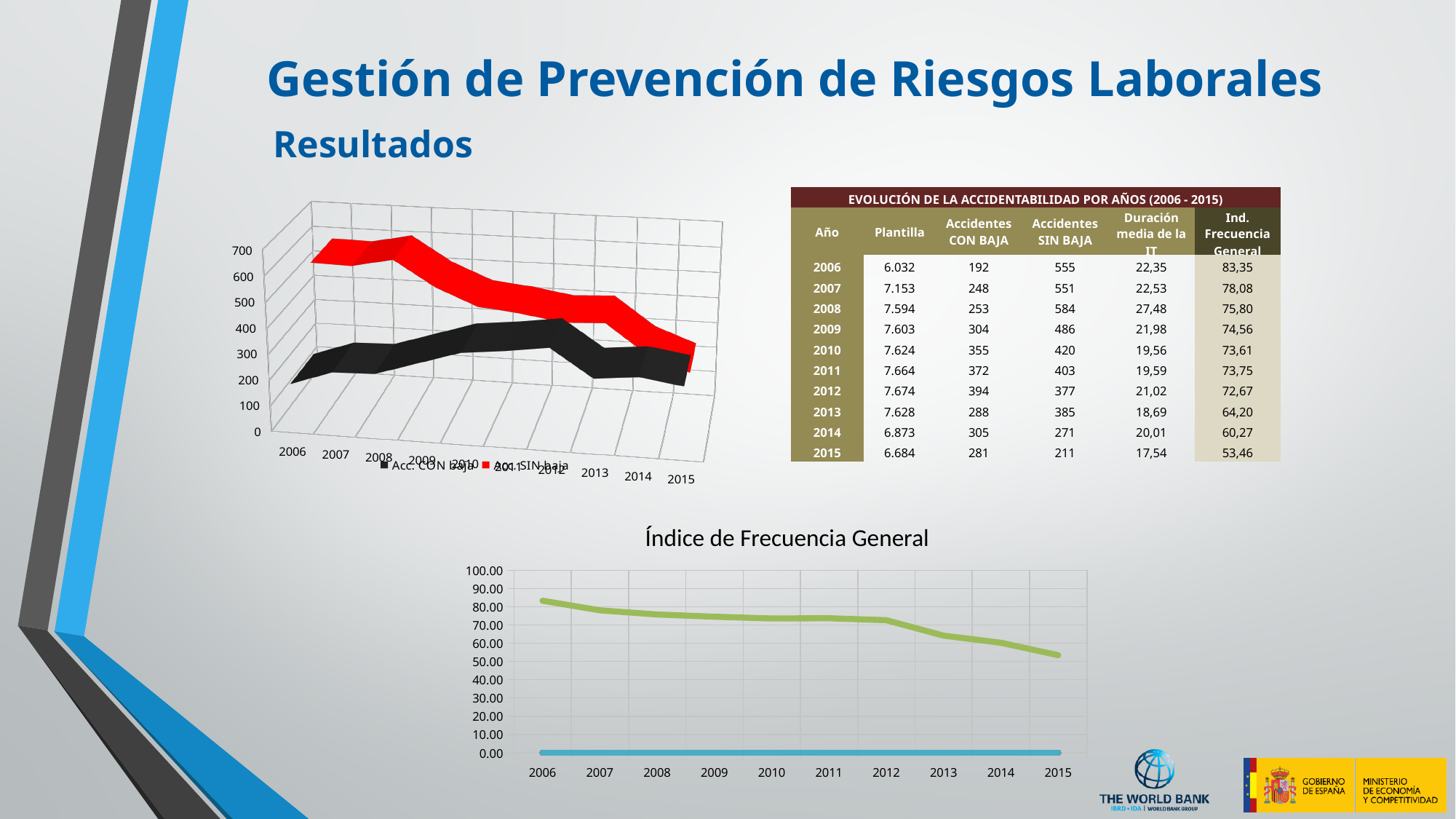
In the 'Índice de Frecuencia General' chart, which year has the highest value? 2006 In the top-left 3D chart, does the 'Acc. SIN baja' series rise or fall from 2006 to 2015? fall In the 'Índice de Frecuencia General' chart, is the value for 2015 greater or less than 60.00? less In the 'Índice de Frecuencia General' chart, do the values rise or fall from 2006 to 2015? fall In the top-left 3D chart, is the 'Acc. SIN baja' value for 2006 greater or less than 400? greater In the top-left 3D chart, which series is drawn in red? Acc. SIN baja How many series does the legend of the top-left 3D chart list? 2 In the 'Índice de Frecuencia General' chart, which year has the lowest value? 2015 In the 'Índice de Frecuencia General' chart, is the value for 2006 greater or less than 70.00? greater In the top-left 3D chart, which series has the larger value in 2006, 'Acc. CON baja' or 'Acc. SIN baja'? Acc. SIN baja What kind of chart is the 'Índice de Frecuencia General' chart at the bottom of the slide? line chart How many years are plotted on the x axis of the 'Índice de Frecuencia General' chart? 10